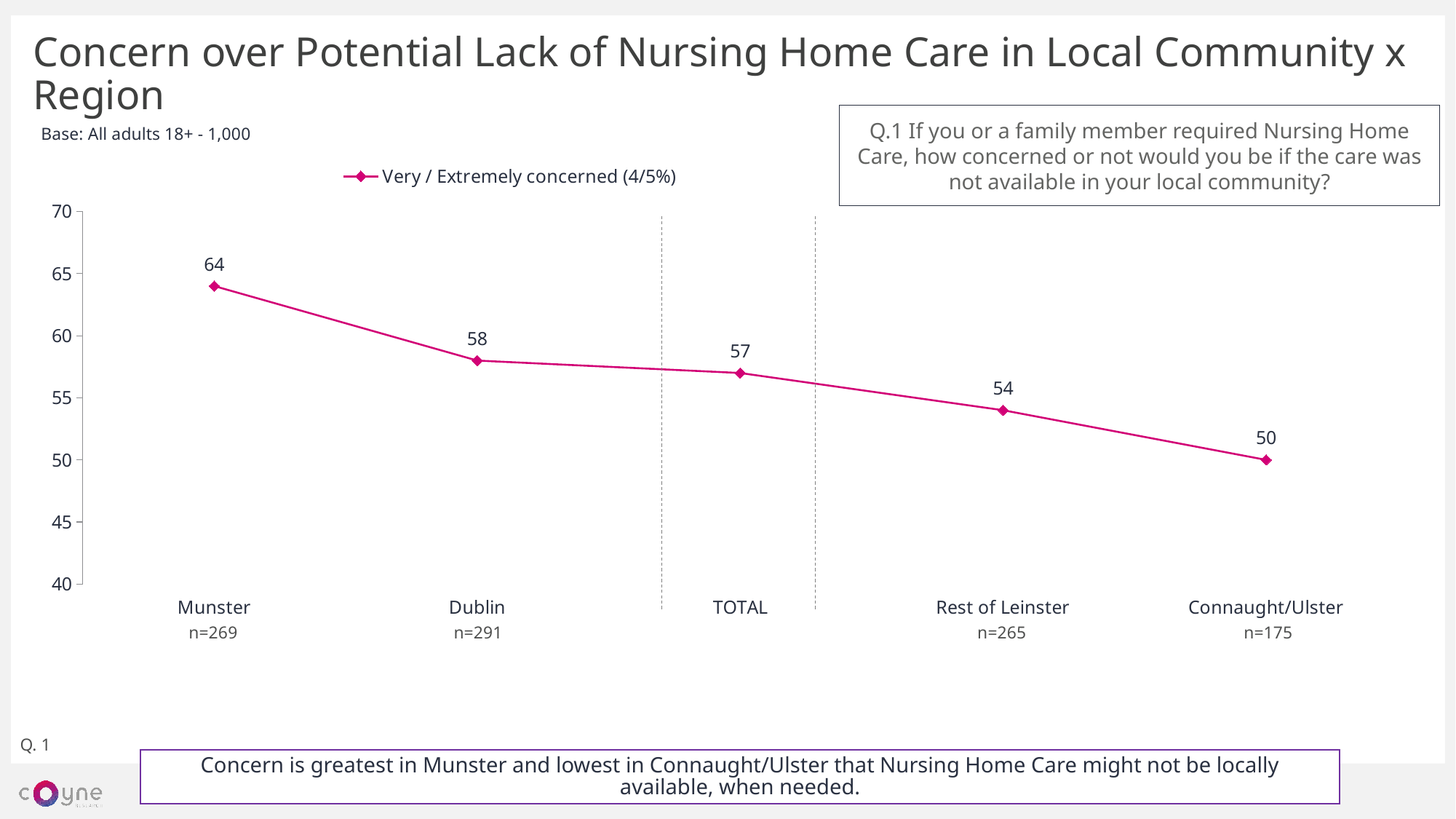
What is the value for Dublin? 58 What is the difference between the values for Munster and Connaught/Ulster? 14 Which category has the lowest value? Connaught/Ulster What is the value for Munster? 64 What is the value for TOTAL? 57 Do the values rise or fall from left to right along the x axis? Fall How many categories are plotted on the x axis? 5 What is the value for Connaught/Ulster? 50 What kind of chart is shown on the slide? Line chart Which is larger, the value for Dublin or the value for Rest of Leinster? Dublin What is the value for Rest of Leinster? 54 Which category has the highest value? Munster